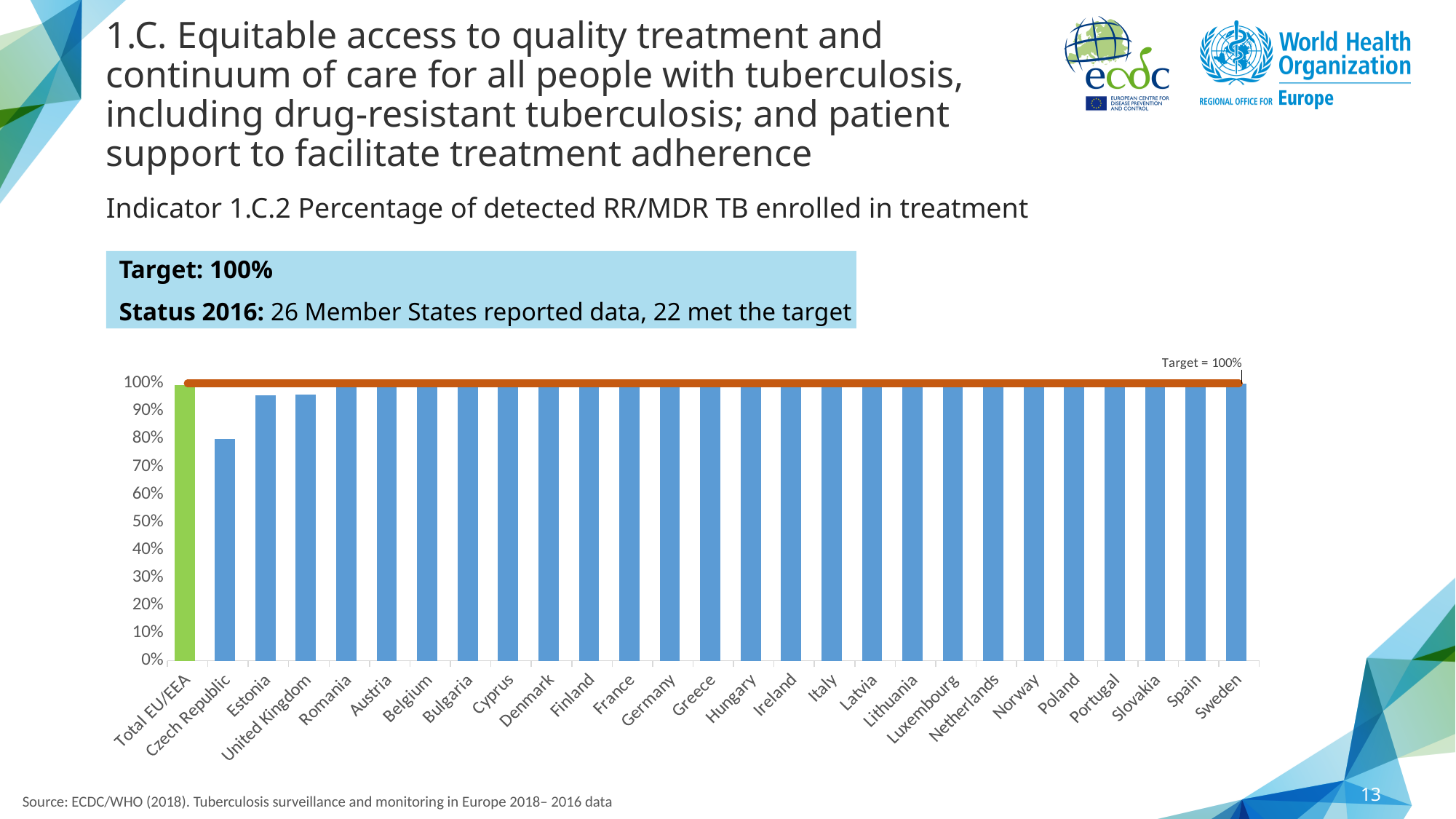
What value does the horizontal target line on the chart represent? 100% Which has the larger value, Czech Republic or United Kingdom? United Kingdom How many bars (categories) are plotted on the chart? 27 What kind of chart is shown on the slide? bar chart Which category has the lowest value on the chart? Czech Republic Which has the larger value, Estonia or Czech Republic? Estonia What colour is the bar for Total EU/EEA? green Is the value for Estonia greater or less than 90%? greater Is the value for Czech Republic greater or less than 90%? less What is the first category on the x axis of the chart? Total EU/EEA Is the value for Total EU/EEA greater or less than 90%? greater